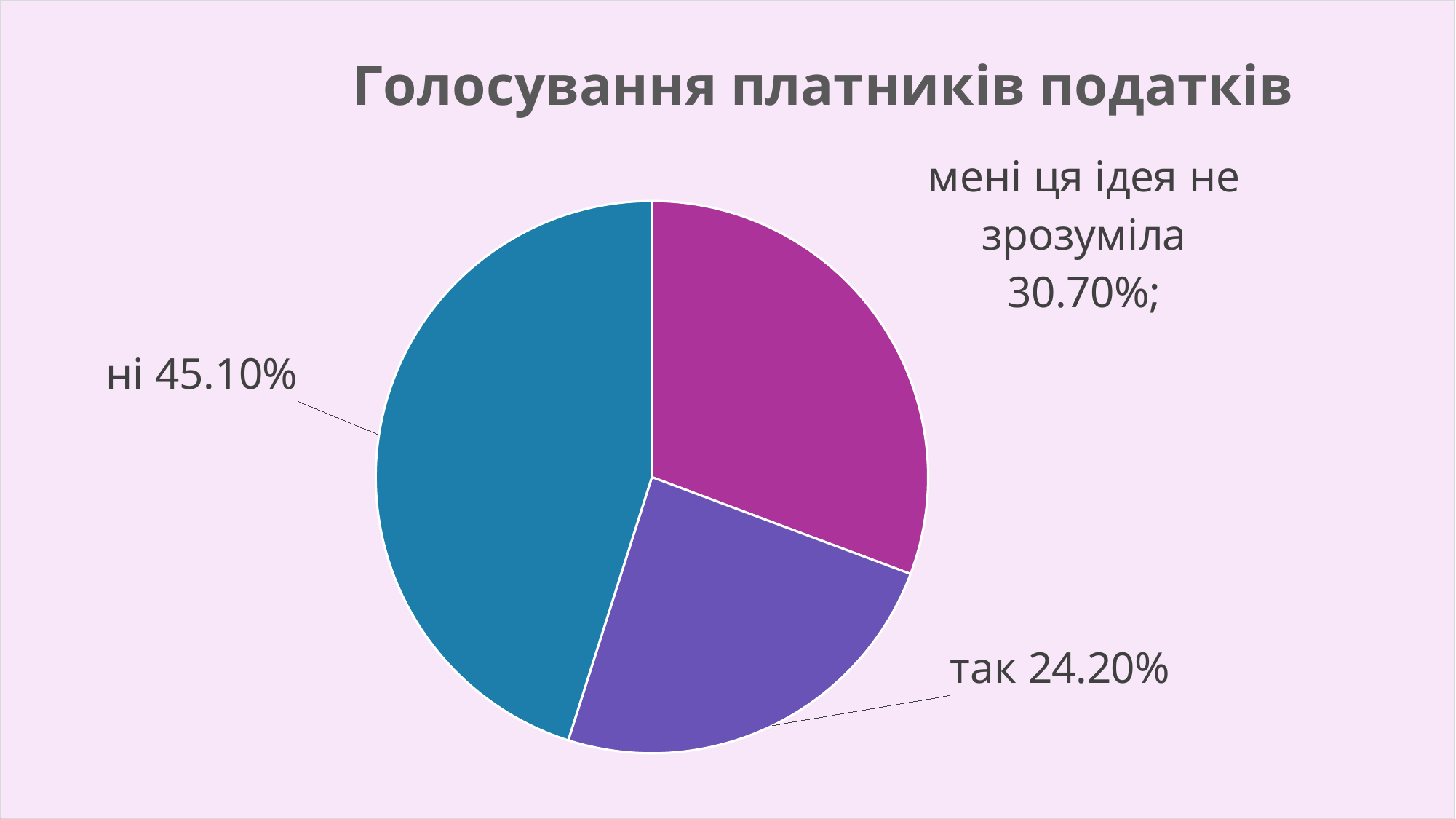
What is the title of the chart? Голосування платників податків What kind of chart is shown on the slide? pie chart What is the difference in percentage points between the "мені ця ідея не зрозуміла" and "так" slices? 6.50% What colour is the "ні" slice? blue Which slice is the largest? ні What share of the pie does the "мені ця ідея не зрозуміла" slice represent? 30.70% Which slice is the smallest? так What share of the pie does the "ні" slice represent? 45.10% How many slices does the pie chart have? 3 What is the difference in percentage points between the "ні" and "так" slices? 20.90% What share of the pie does the "так" slice represent? 24.20% Which is larger, the "так" slice or the "мені ця ідея не зрозуміла" slice? мені ця ідея не зрозуміла